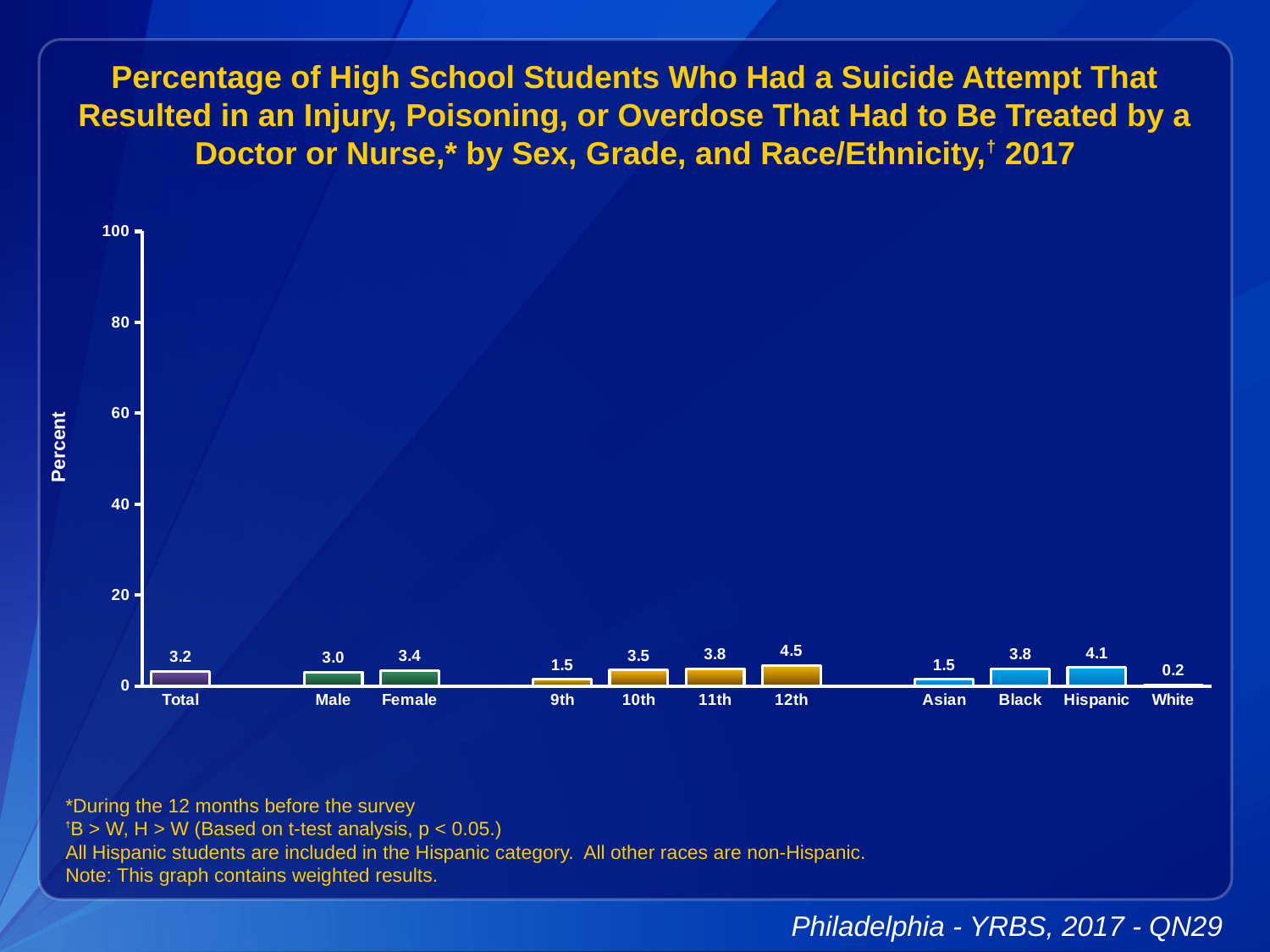
Which is larger, the value for Black or the value for Hispanic? Hispanic Which category has the highest value? 12th Is the value for 12th grade greater or less than 20? less Do the values rise or fall from 9th grade to 12th grade? rise What is the difference between the values for Female and Male? 0.4 Which category has the lowest value? White What is the value for Hispanic? 4.1 What kind of chart is this? bar chart What is the value for 9th grade? 1.5 What is the value for Total? 3.2 What is the value for Female? 3.4 How many categories are shown on the x axis? 11